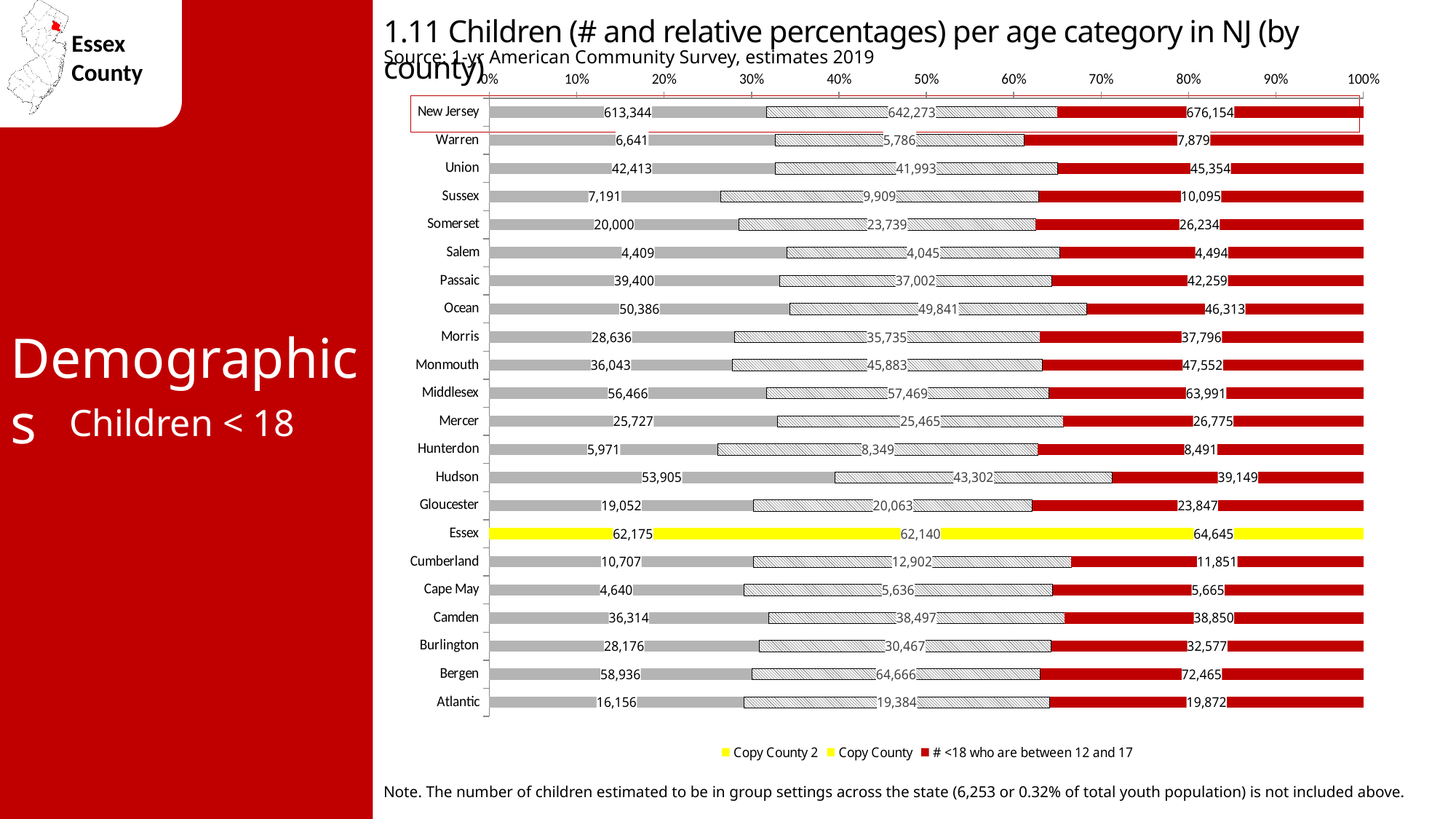
What is the value of the '# <18 who are between 12 and 17' segment for Essex? 64,645 How many series does the legend list? 3 Excluding the New Jersey row, which county has the highest '# <18 who are between 12 and 17' value? Bergen What kind of chart is shown on the slide? bar chart What is the value of the '# <18 who are between 12 and 17' segment for New Jersey? 676,154 How many categories (rows) are plotted on the chart? 22 Which county has the lowest '# <18 who are between 12 and 17' value? Salem Which is larger, the first segment value for Hudson or the first segment value for Ocean? Hudson What is the difference between the '# <18 who are between 12 and 17' values for Bergen and Essex? 7,820 What is the value of the first (leftmost) segment for Hudson? 53,905 What is the total of the three segments for Essex? 188,960 Is the share of the first (leftmost) segment for Hudson greater or less than 30%? greater